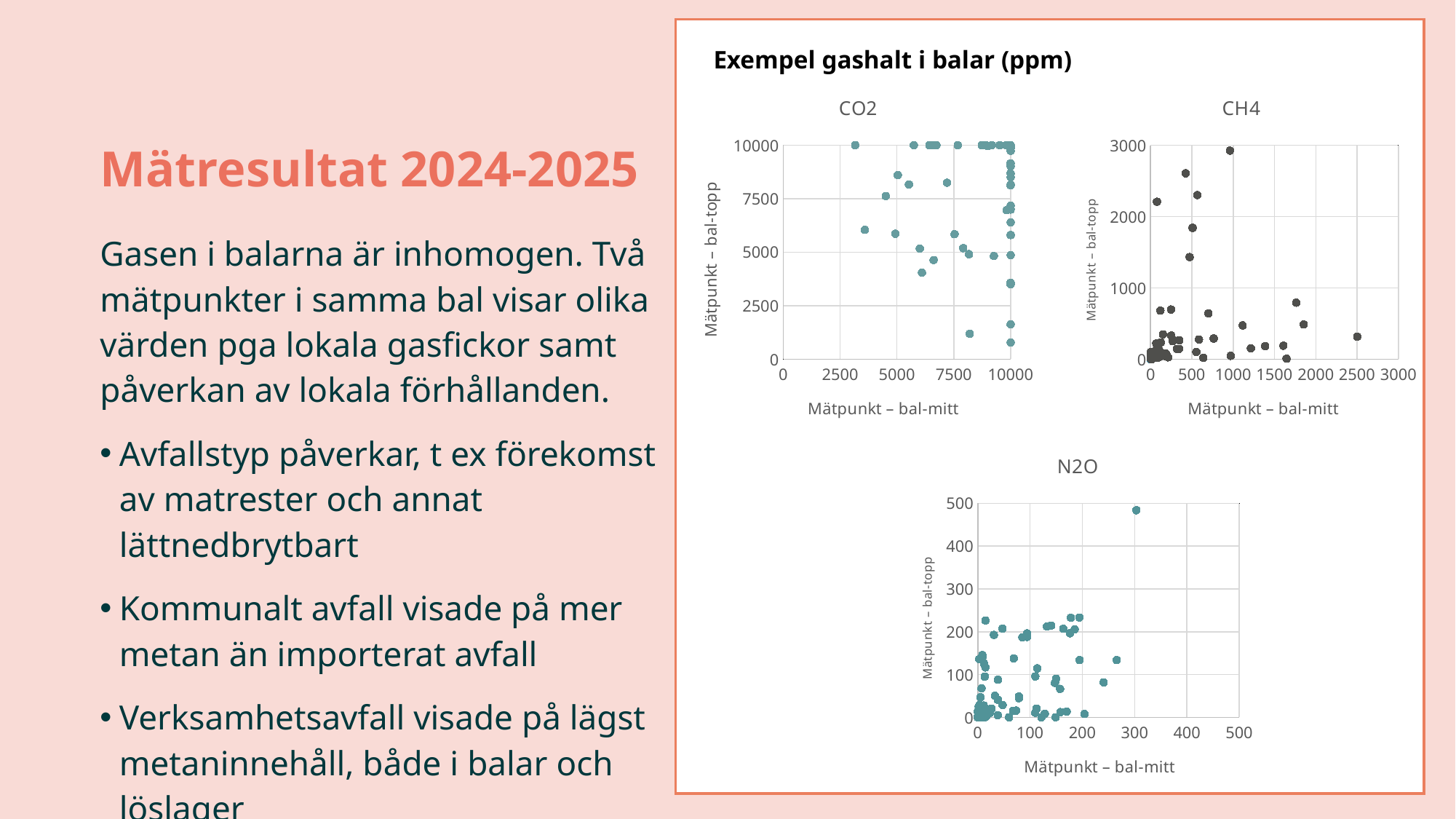
What is the maximum value shown on the y axis of the CO2 chart? 10000 In the CH4 chart, is the y value of the highest point greater or less than 2500? greater In the N2O chart, is the x value of the highest point greater or less than 200? greater In the N2O chart, is the y value of the highest point greater or less than 400? greater How many charts are shown on the slide? 3 What is the x-axis label of the CH4 chart? Mätpunkt – bal-mitt What kind of chart is the N2O chart? scatter chart What is the maximum value shown on the y axis of the N2O chart? 500 What is the maximum value shown on the x axis of the CH4 chart? 3000 What kind of chart is the CO2 chart? scatter chart What is the overall title above the three charts? Exempel gashalt i balar (ppm) Which of the three charts has axes that go up to 10000? CO2